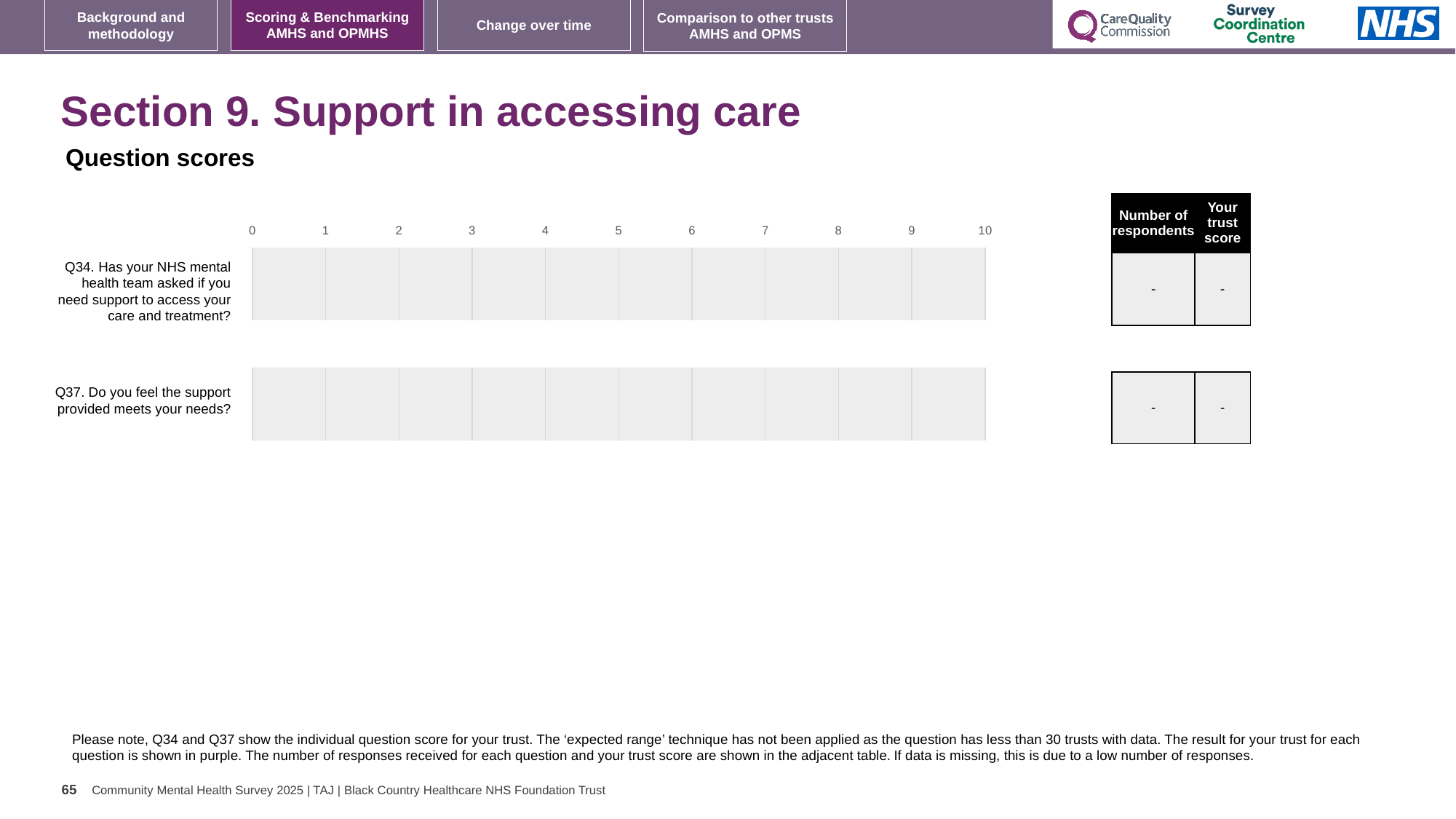
What is shown in the 'Your trust score' column for Q34? - How many questions (categories) are listed on the chart? 2 What kind of chart is shown on the slide? bar chart What is the highest value shown on the chart's x axis? 10 What is shown in the 'Your trust score' column for Q37? - What is shown in the 'Number of respondents' column for Q34? - What is shown in the 'Number of respondents' column for Q37? - What is the lowest value shown on the chart's x axis? 0